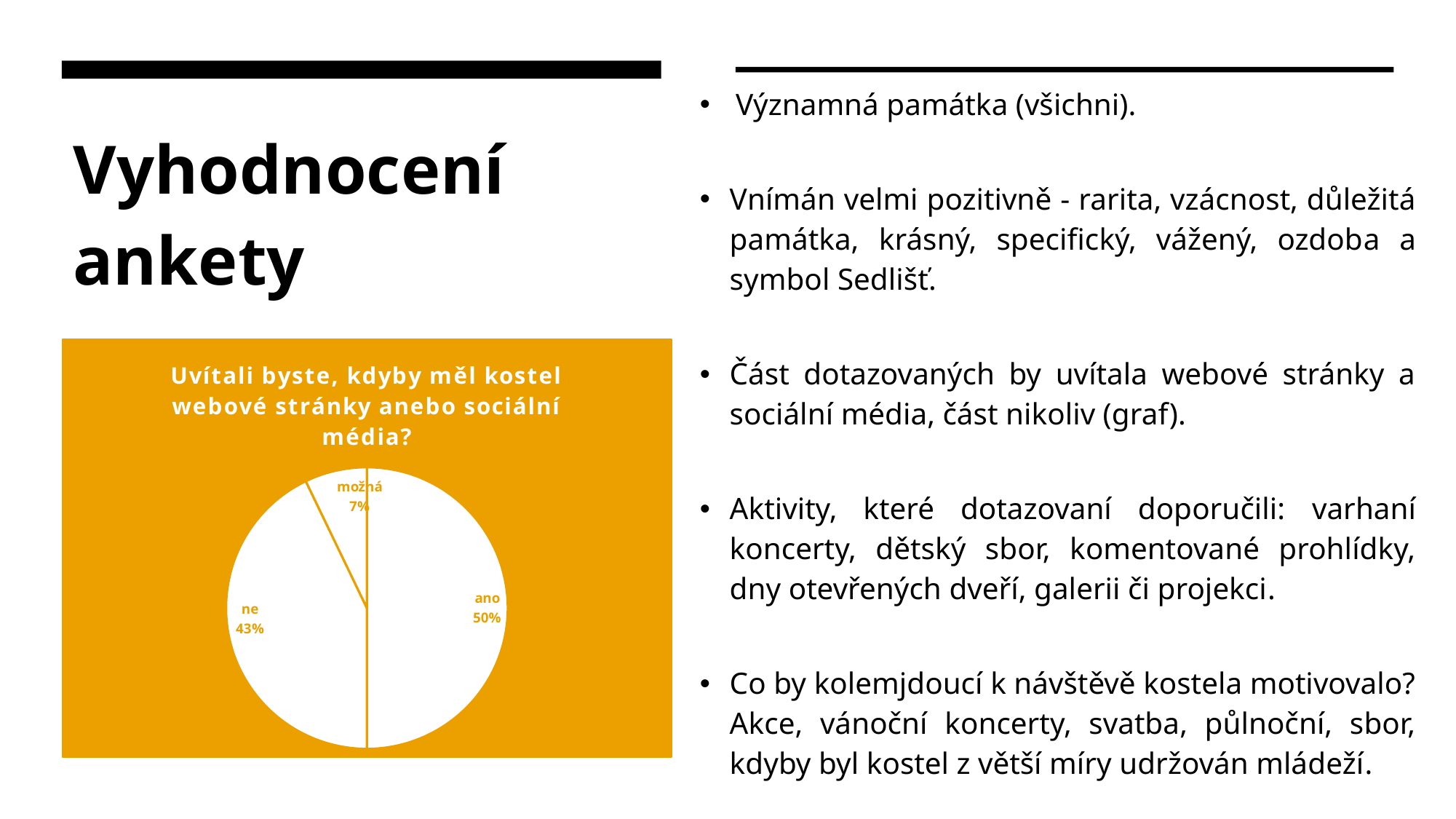
How many slices does the pie chart have? 3 Which slice of the pie is the largest? ano What is the difference in percentage points between the "ano" and "ne" slices? 7% What share of the pie is labelled "ano"? 50% What is the difference in percentage points between the "ne" and "možná" slices? 36% Which slice of the pie is the smallest? možná What kind of chart is shown on the slide? pie chart What is the title of the chart? Uvítali byste, kdyby měl kostel webové stránky anebo sociální média? What share of the pie is labelled "ne"? 43% Which is larger, the "ne" slice or the "možná" slice? ne What share of the pie is labelled "možná"? 7% What colour are the slices of the pie chart? white